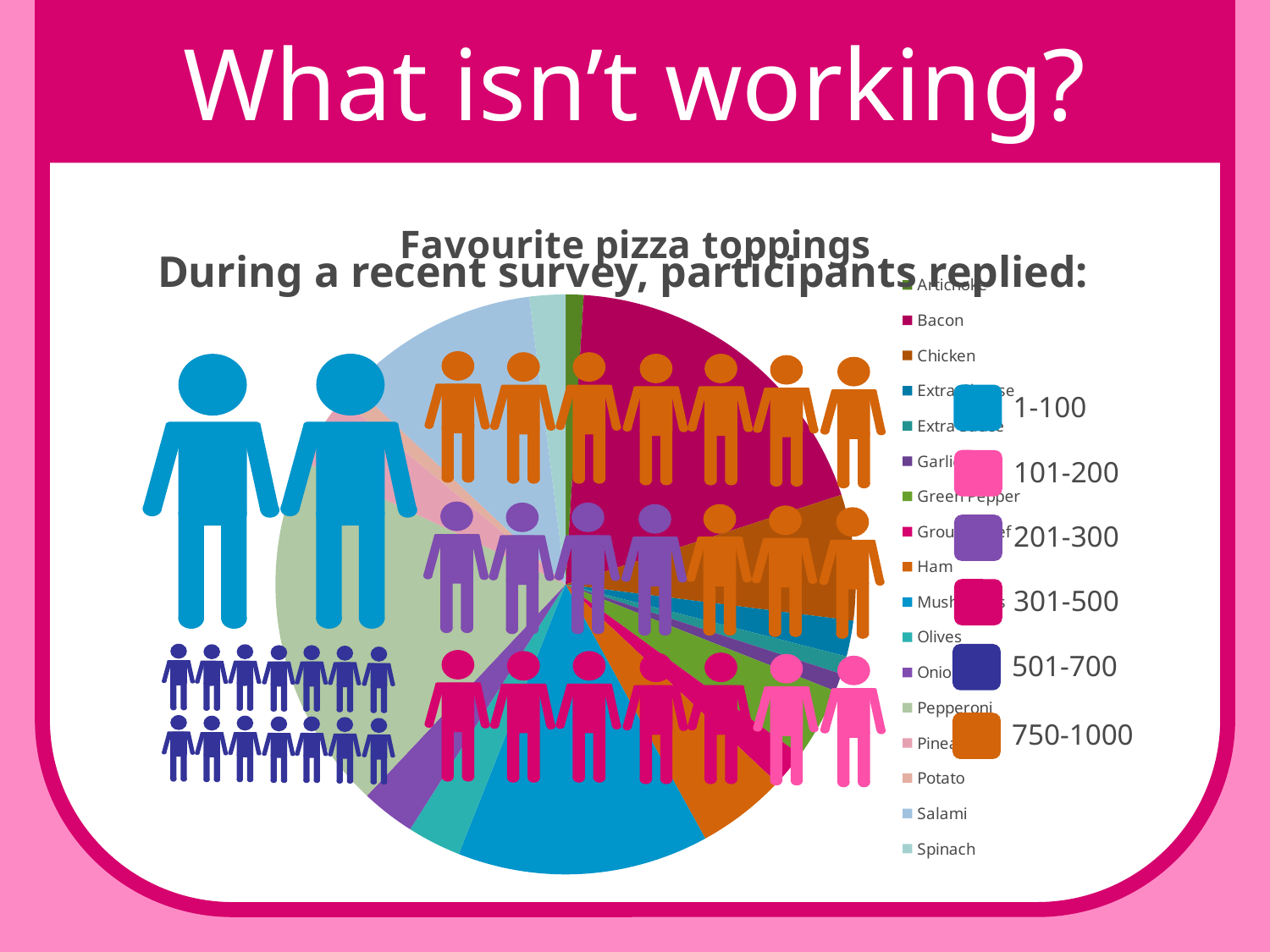
Which slice is larger, Salami or Spinach? Salami What kind of chart is shown on the slide? pie chart Which topping is listed last in the chart's legend? Spinach Which slice is larger, Bacon or Potato? Bacon How many toppings are listed in the chart's legend? 17 Which slice is larger, Bacon or Spinach? Bacon What is the title of the chart? Favourite pizza toppings